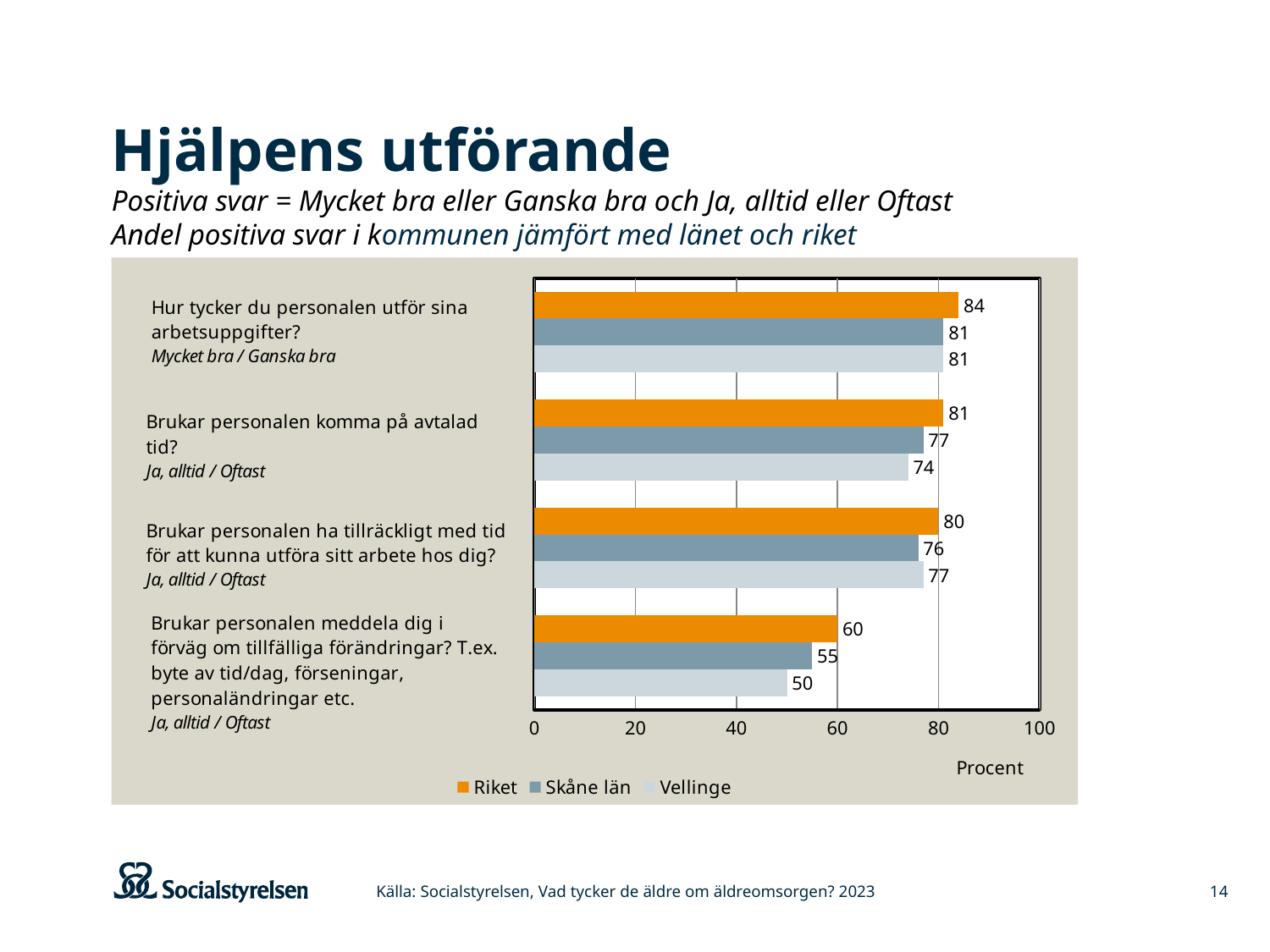
What is the difference between the Riket and Vellinge values on the question "Brukar personalen meddela dig i förväg om tillfälliga förändringar?"? 10 How many questions (categories) are shown in the chart? 4 On the question "Brukar personalen ha tillräckligt med tid för att kunna utföra sitt arbete hos dig?", which is larger, Skåne län or Vellinge? Vellinge What is the value for Skåne län on the question "Brukar personalen ha tillräckligt med tid för att kunna utföra sitt arbete hos dig?"? 76 What is the value for Vellinge on the question "Brukar personalen komma på avtalad tid?"? 74 What is the value for Vellinge on the question "Brukar personalen meddela dig i förväg om tillfälliga förändringar?"? 50 What is the value for Riket on the question "Hur tycker du personalen utför sina arbetsuppgifter?"? 84 For which question is the Vellinge value highest? Hur tycker du personalen utför sina arbetsuppgifter? What is the label of the horizontal axis? Procent For which question is the Riket value lowest? Brukar personalen meddela dig i förväg om tillfälliga förändringar? How many series does the legend list? 3 What kind of chart is shown on the slide? Bar chart